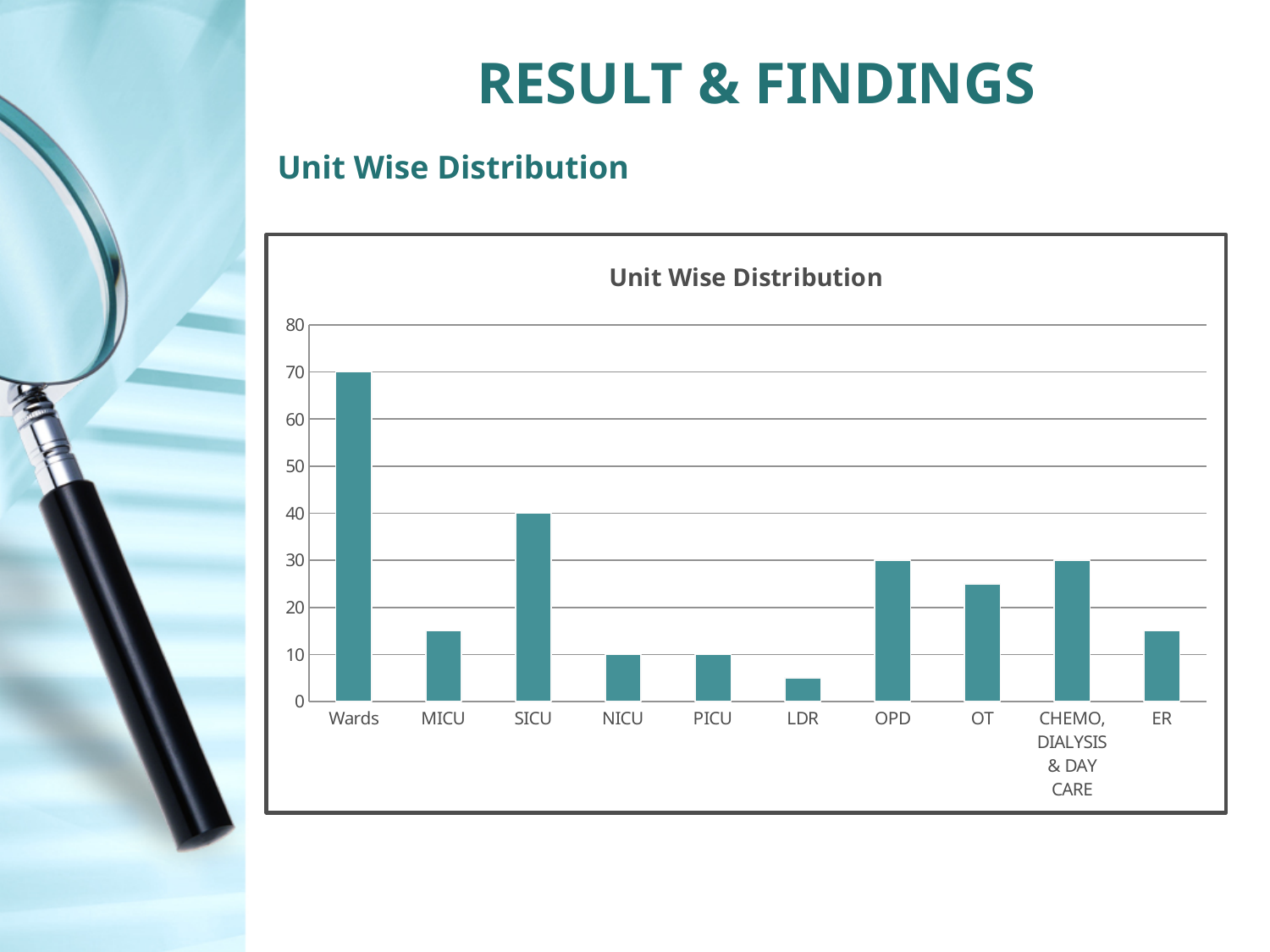
Which unit has the lowest value? LDR Which is larger, the value for SICU or the value for OPD? SICU What type of chart is shown on the slide? bar chart What is the value for SICU? 40 What is the difference between the values for Wards and SICU? 30 Is the value for OT greater or less than 20? greater Is the value for LDR greater or less than 10? less Which unit has the highest value? Wards How many units (categories) are shown on the x axis? 10 What is the value for Wards? 70 What is the title of the chart? Unit Wise Distribution What is the value for OPD? 30